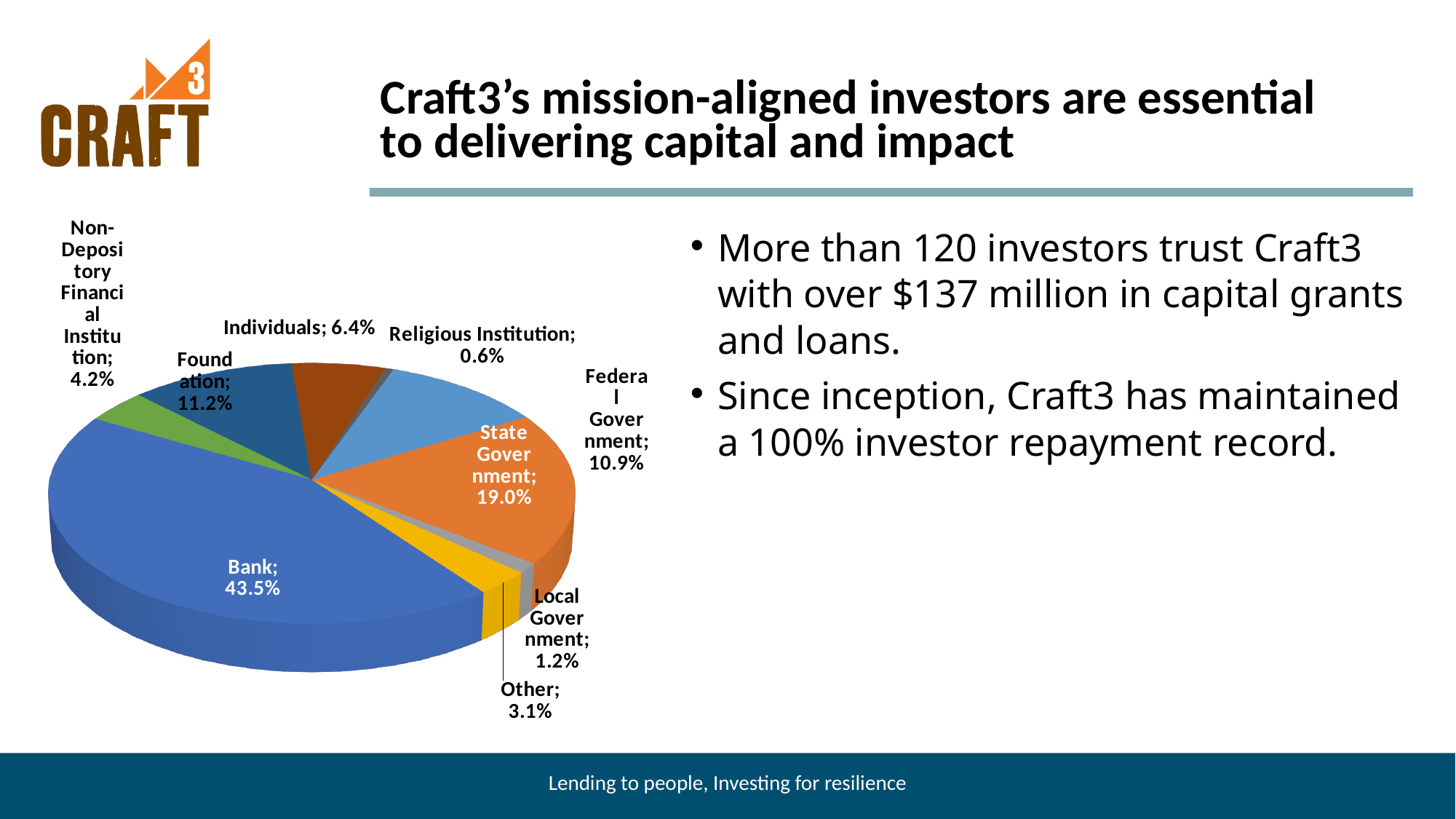
What share of the pie does Bank account for? 43.5% What is the difference between the Bank share and the State Government share? 24.5% What is the value shown for Foundation? 11.2% Which is larger, the share for Foundation or the share for Federal Government? Foundation What kind of chart is shown on the slide? Pie chart What is the value shown for Local Government? 1.2% How many categories are shown in the pie chart? 9 Which category has the largest slice of the pie? Bank What is the value shown for Federal Government? 10.9% What is the value shown for Religious Institution? 0.6% What is the value shown for State Government? 19.0% Which category has the smallest slice of the pie? Religious Institution